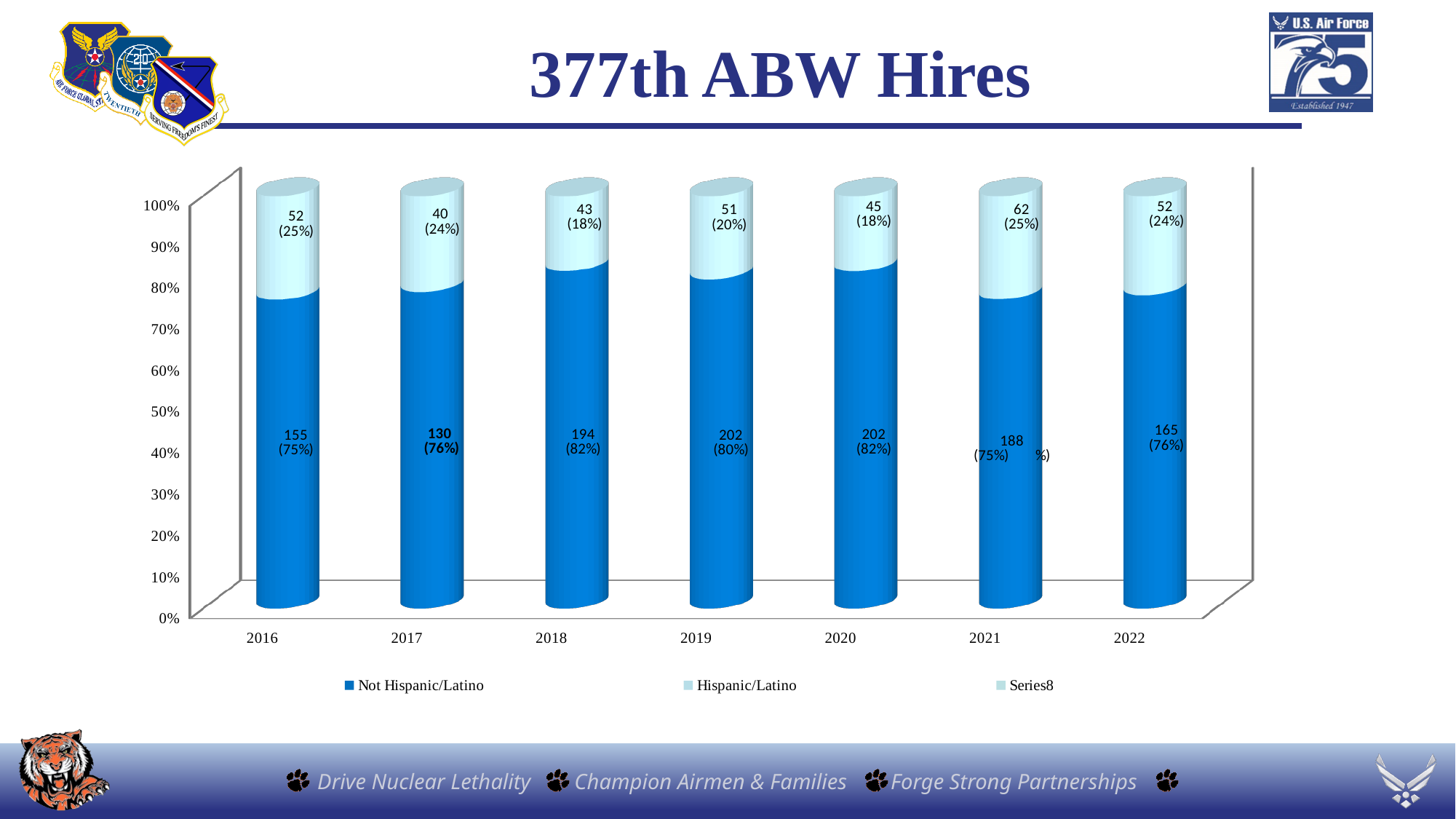
How many years are shown on the x axis of the chart? 7 In which year is the Not Hispanic/Latino hire count the lowest? 2017 What kind of chart is shown on the slide? Stacked bar chart What is the number of Hispanic/Latino hires shown for 2021? 62 What is the total number of hires (Not Hispanic/Latino plus Hispanic/Latino) in 2016? 207 What is the difference between the Hispanic/Latino hires in 2021 and in 2016? 10 What is the difference between the Not Hispanic/Latino hires in 2018 and in 2017? 64 Which year has more Hispanic/Latino hires, 2019 or 2020? 2019 How many series does the legend list? 3 In which year is the Hispanic/Latino hire count the highest? 2021 What is the number of Not Hispanic/Latino hires shown for 2018? 194 What percentage label is shown for Hispanic/Latino hires in 2019? 20%